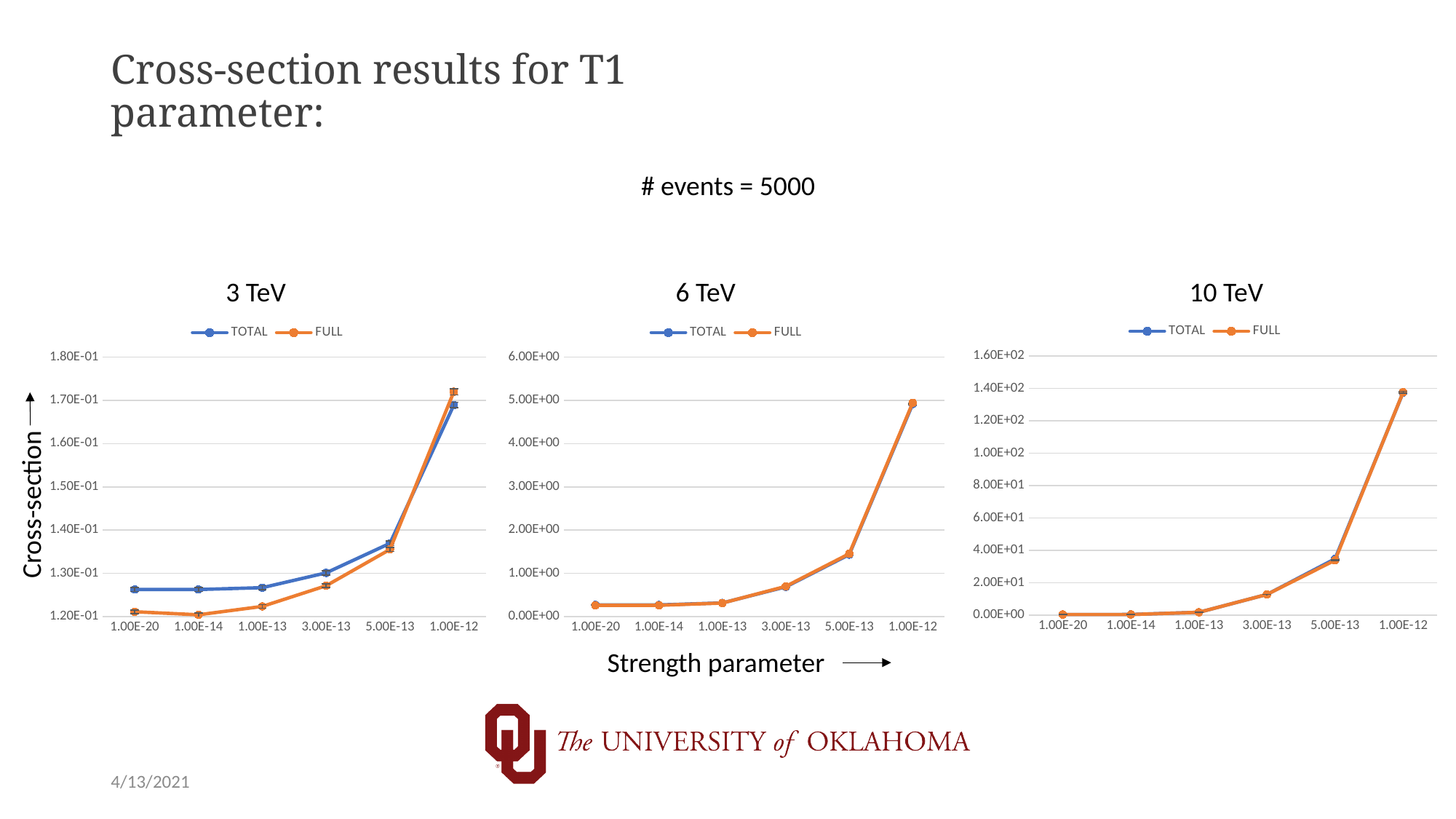
In the 3 TeV chart, is the FULL value at 1.00E-12 greater or less than 1.70E-01? greater In the 3 TeV chart, is the TOTAL value at 1.00E-20 greater or less than 1.30E-01? less In the 6 TeV chart, at which strength parameter is the FULL series highest? 1.00E-12 In the 10 TeV chart, do the values rise or fall as the strength parameter increases along the x axis? rise How many series does the legend of the 6 TeV chart list? 2 What kind of chart is the 3 TeV chart? line chart How many x-axis points are plotted in the 10 TeV chart? 6 What is the title of the rightmost chart? 10 TeV In the 10 TeV chart, is the TOTAL value at 5.00E-13 greater or less than 4.00E+01? less In the 3 TeV chart, at 1.00E-13, which series has the larger value, TOTAL or FULL? TOTAL In the 3 TeV chart, at which strength parameter is the FULL series lowest? 1.00E-14